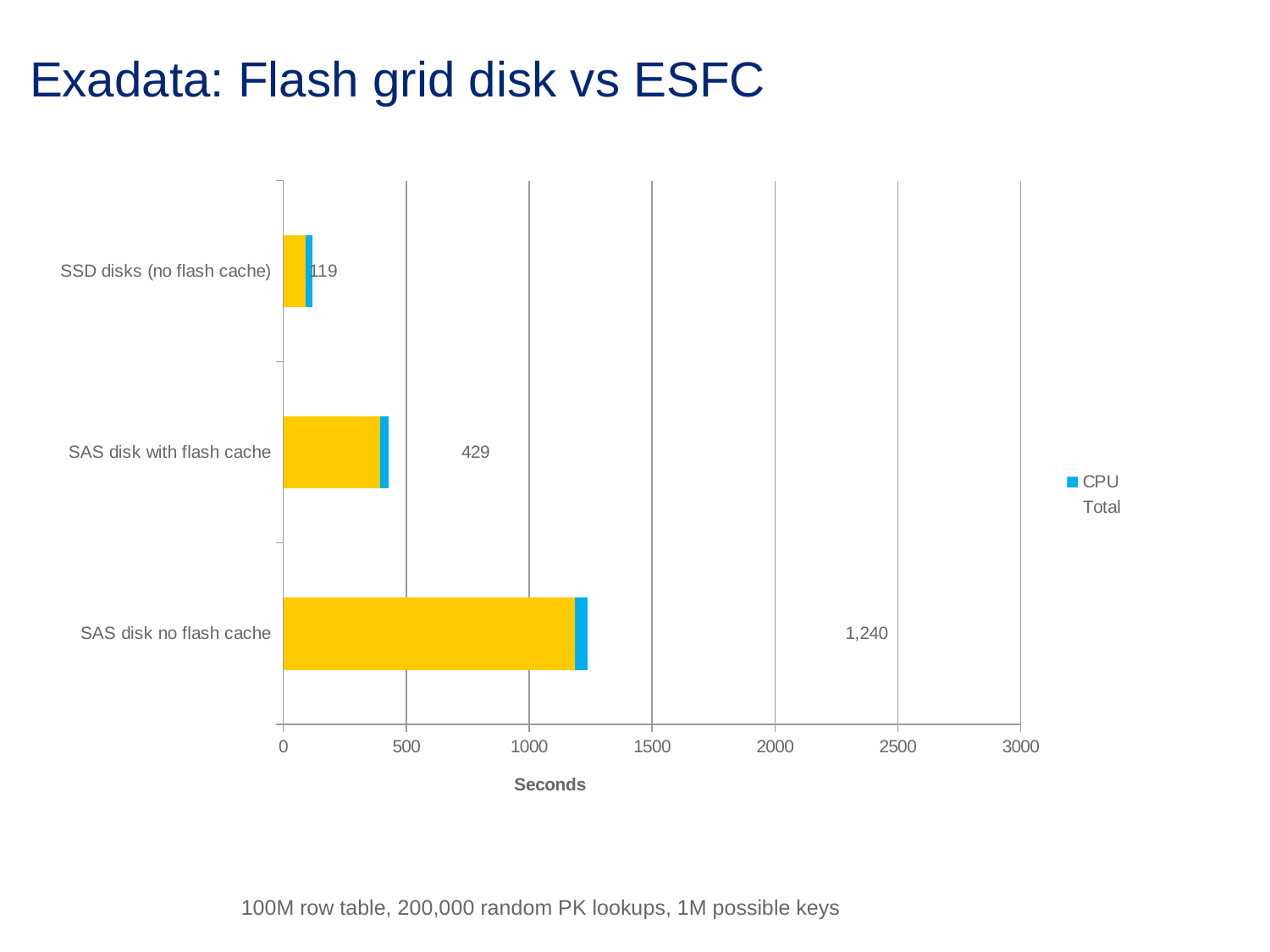
What is the difference between the labelled values for SAS disk no flash cache and SAS disk with flash cache? 811 What value is labelled for SAS disk no flash cache? 1,240 What value is labelled for SSD disks (no flash cache)? 119 What is the difference between the labelled values for SAS disk with flash cache and SSD disks (no flash cache)? 310 Is the value for SAS disk no flash cache greater or less than 1000? greater How many categories are shown on the chart? 3 Which category has the lowest labelled value? SSD disks (no flash cache) What value is labelled for SAS disk with flash cache? 429 How many series does the legend list? 2 Which category has the highest labelled value? SAS disk no flash cache What kind of chart is shown on the slide? Bar chart Which is larger, the labelled value for SAS disk with flash cache or for SSD disks (no flash cache)? SAS disk with flash cache